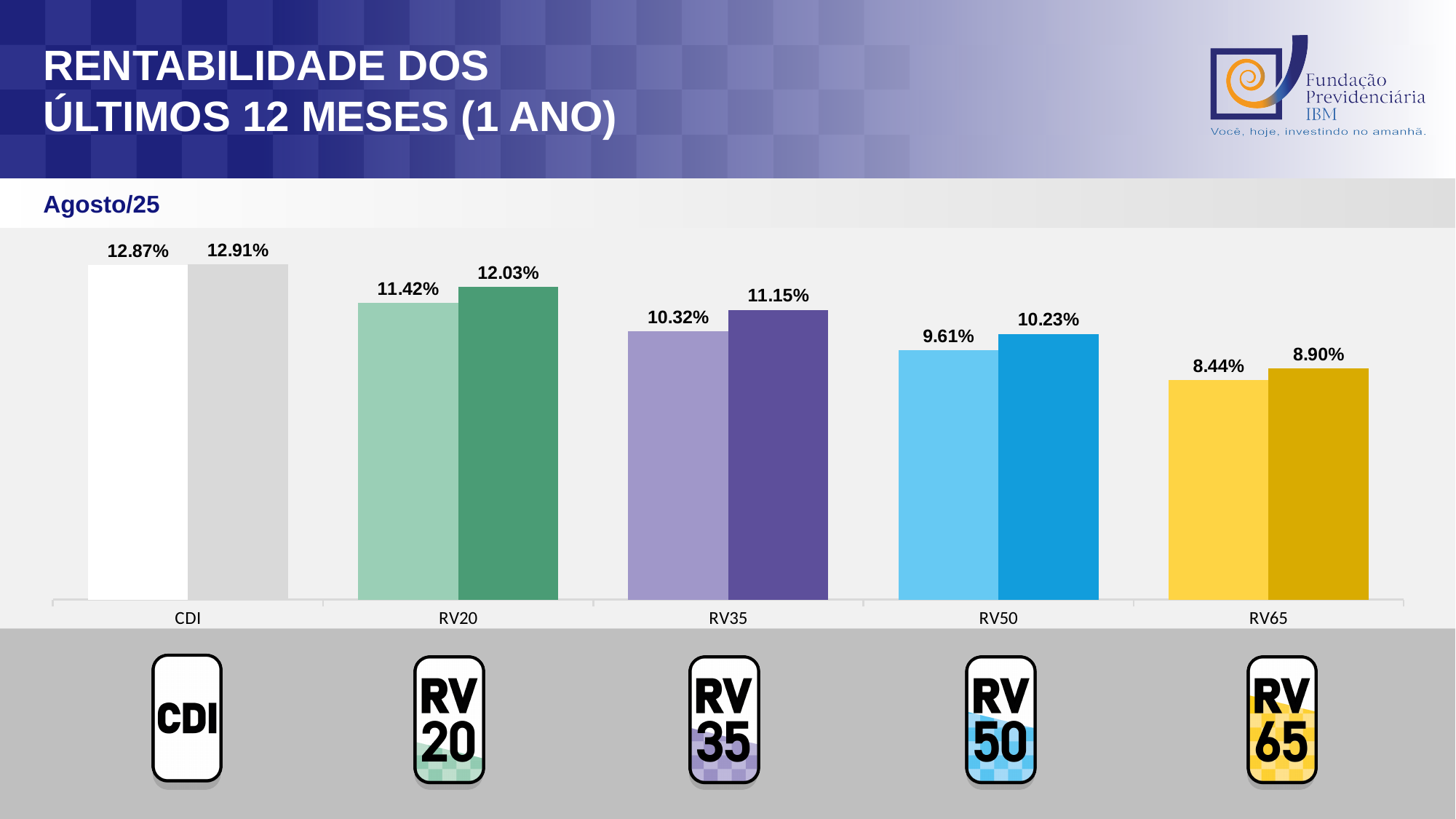
What value is shown on the right bar for RV50? 10.23% Do the left-bar values rise or fall from CDI to RV65 along the x axis? Fall How many categories are shown on the x axis? 5 What value is shown on the left bar for CDI? 12.87% Which category has the highest right-bar value? CDI What is the difference between the right bar and the left bar for RV20? 0.61% What value is shown on the right bar for RV20? 12.03% What value is shown on the left bar for RV65? 8.44% Which category has the lowest left-bar value? RV65 Which is larger, the left bar for RV35 or the right bar for RV50? Left bar for RV35 What kind of chart is shown on the slide? Bar chart What value is shown on the left bar for RV35? 10.32%